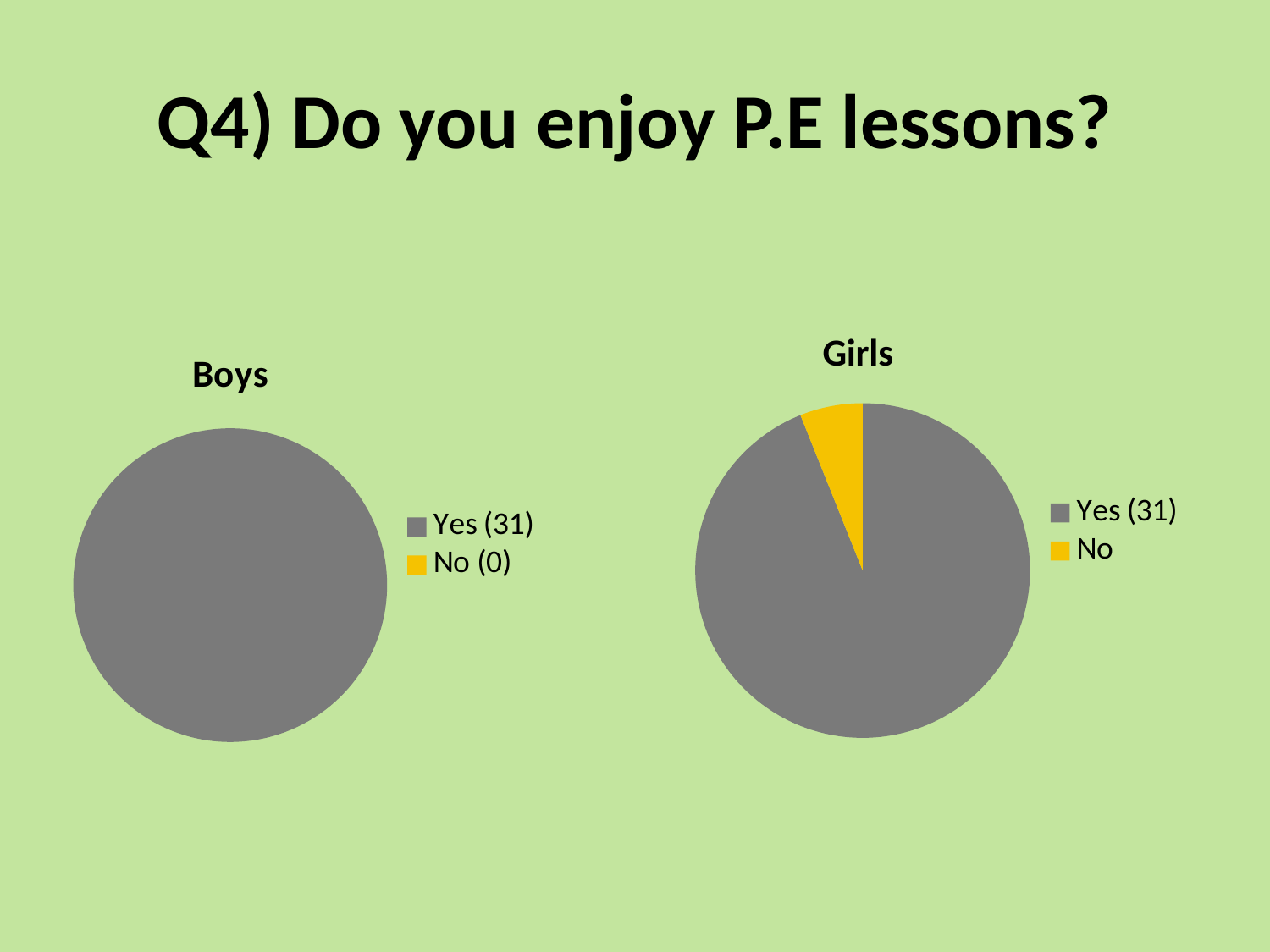
In the Girls chart, what colour is the No slice? yellow In the Girls chart, which answer has the smallest slice? No What is the title of the slide containing the two pie charts? Q4) Do you enjoy P.E lessons? In the Boys chart, how many boys answered Yes? 31 How many entries does the legend of the Girls chart list? 2 In the Boys chart, how many boys answered No? 0 In the Boys chart, what is the difference between the Yes and No counts? 31 What kind of chart is the Boys chart? pie chart In the Girls chart, which answer has the largest slice? Yes How many categories does the Boys chart legend list? 2 In the Boys chart, what share of the pie does Yes take? 100% In the Girls chart, how many girls answered Yes? 31